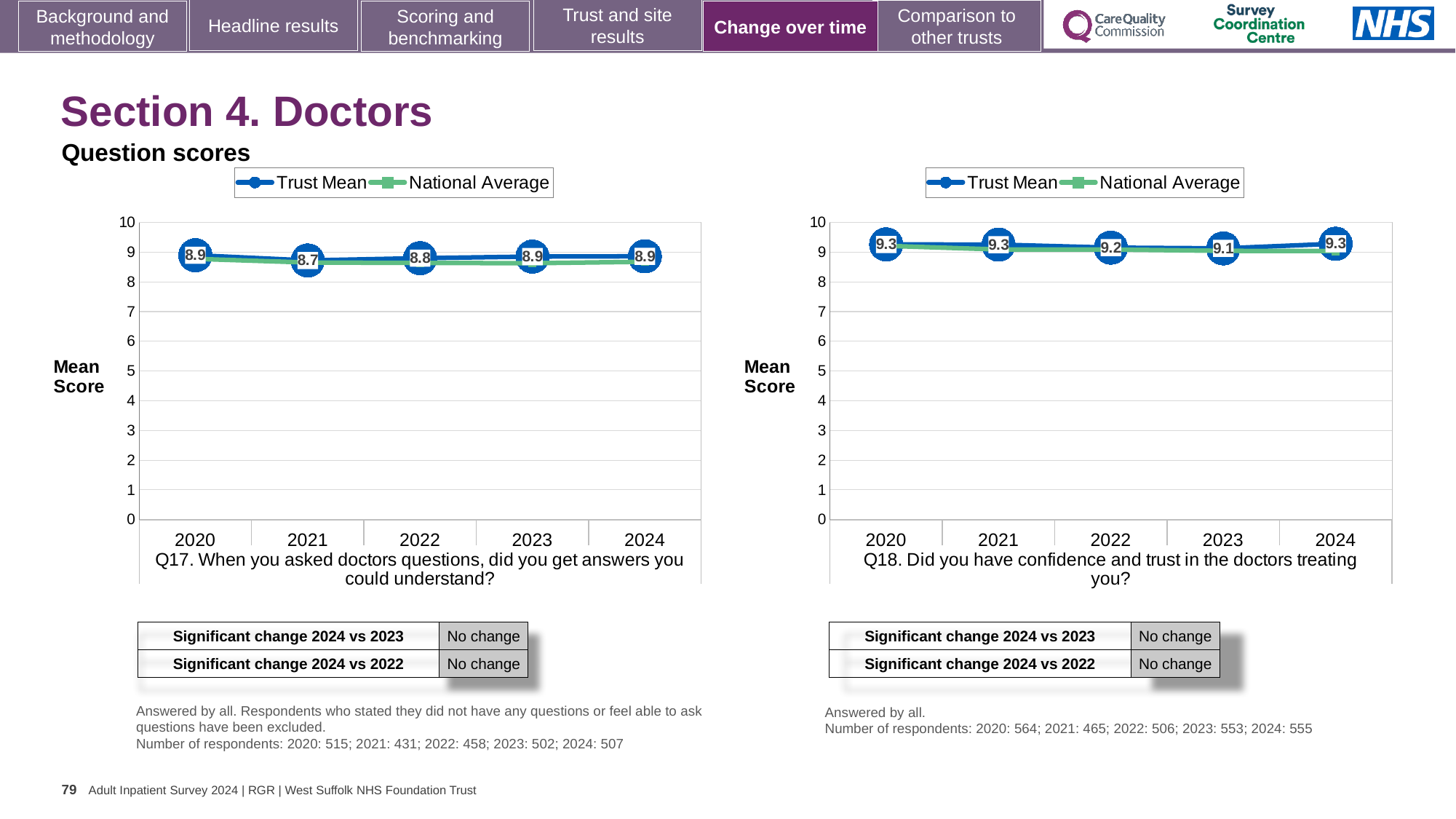
How many series does the legend of the Q17 chart (left) list? 2 In the Q17 chart (left), what is the difference between the Trust Mean scores for 2024 and 2021? 0.2 In the Q18 chart (right), which year has the lowest Trust Mean score? 2023 In the Q18 chart (right), what is the Trust Mean score for 2023? 9.1 What kind of chart is the Q18 chart (right)? line chart In the Q18 chart (right), is the Trust Mean score for 2020 larger or smaller than the score for 2023? larger In the Q17 chart (left), which year has the lowest Trust Mean score? 2021 How many years are plotted on the x axis of the Q18 chart (right)? 5 In the Q18 chart (right), what is the Trust Mean score for 2020? 9.3 In the Q17 chart (left), what is the Trust Mean score for 2024? 8.9 In the Q17 chart (left), what is the Trust Mean score for 2021? 8.7 In the Q17 chart (left), is the National Average value for 2021 greater or less than 8? greater